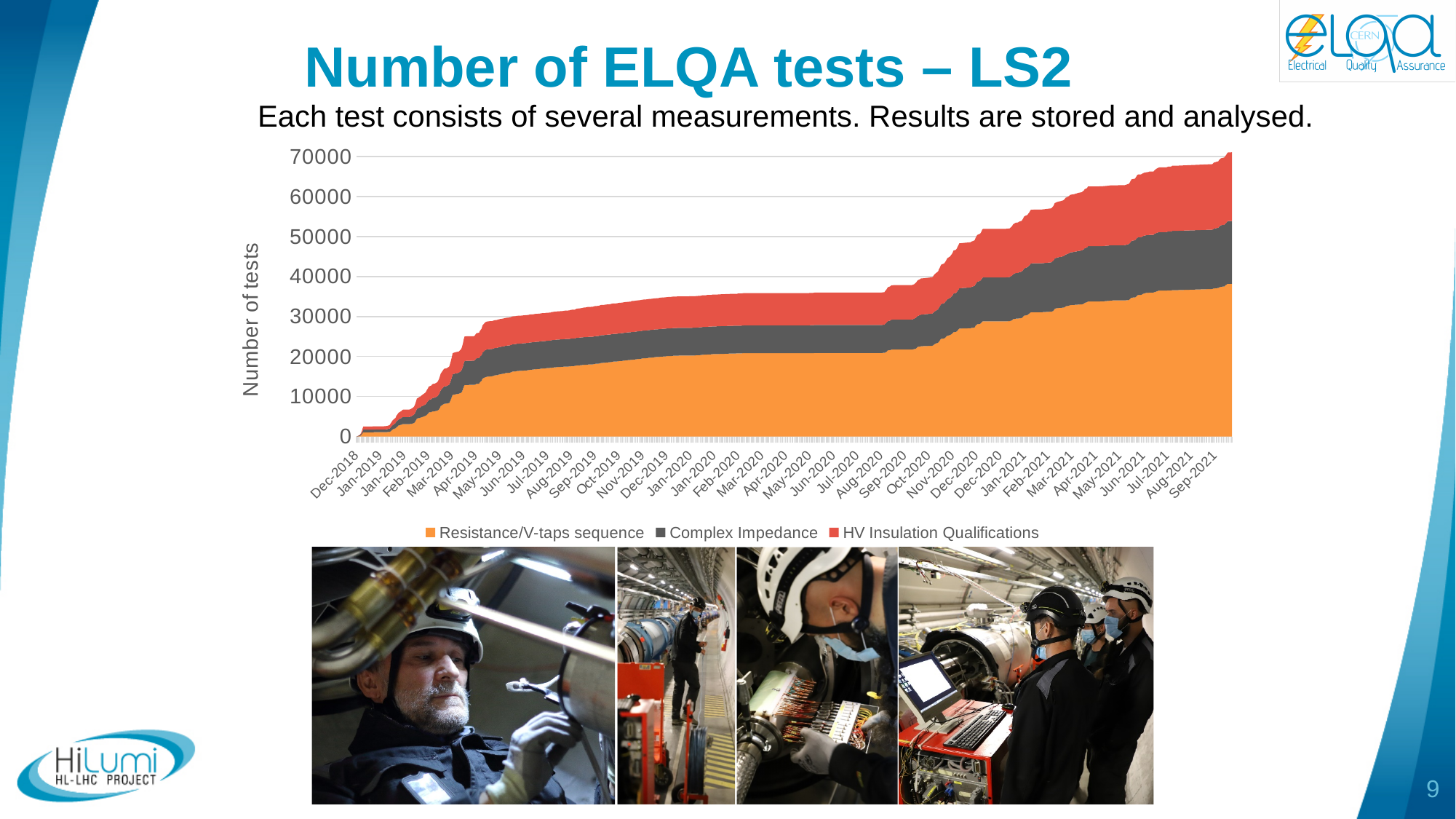
Is the value for Resistance/V-taps sequence at Sep-2021 greater or less than 30000? greater At which month does the total number of tests reach its highest value? Sep-2021 What kind of chart is shown on the slide? Stacked area chart Is the total number of tests at Jan-2019 greater or less than 10000? less What is the title of the chart? Number of ELQA tests – LS2 What is the label of the vertical axis? Number of tests Is the total number of tests at Oct-2020 greater or less than 50000? less How many series does the legend list? 3 Which series accounts for the largest number of tests at Sep-2021? Resistance/V-taps sequence Do the total number of tests rise or fall from Dec-2018 to Sep-2021? Rise